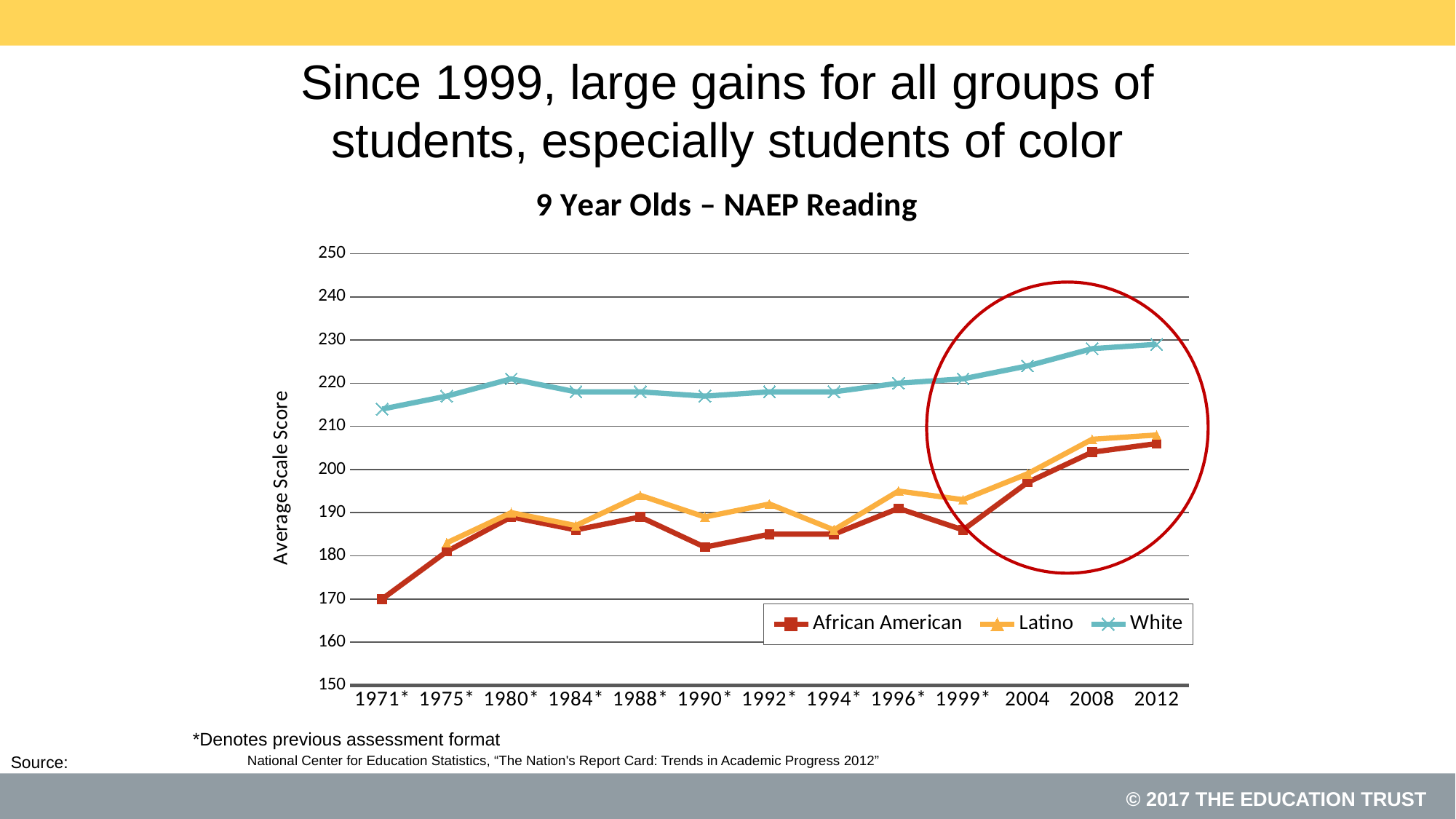
What is the average scale score for African American students in 1971*? 170 What is the label on the y axis? Average Scale Score Is the value for Latino students in 2012 greater or less than 200? greater Is the value for White students in 2012 greater or less than 220? greater In which year is the African American series at its lowest? 1971* How many years are plotted along the x axis? 13 In which year is the White series at its lowest? 1971* Do the values for African American students rise or fall from 1999* to 2012? rise How many series does the legend list? 3 What kind of chart is shown on the slide? line chart Is the value for African American students in 1990* greater or less than 190? less In 2012, which is larger: the value for White students or for African American students? White